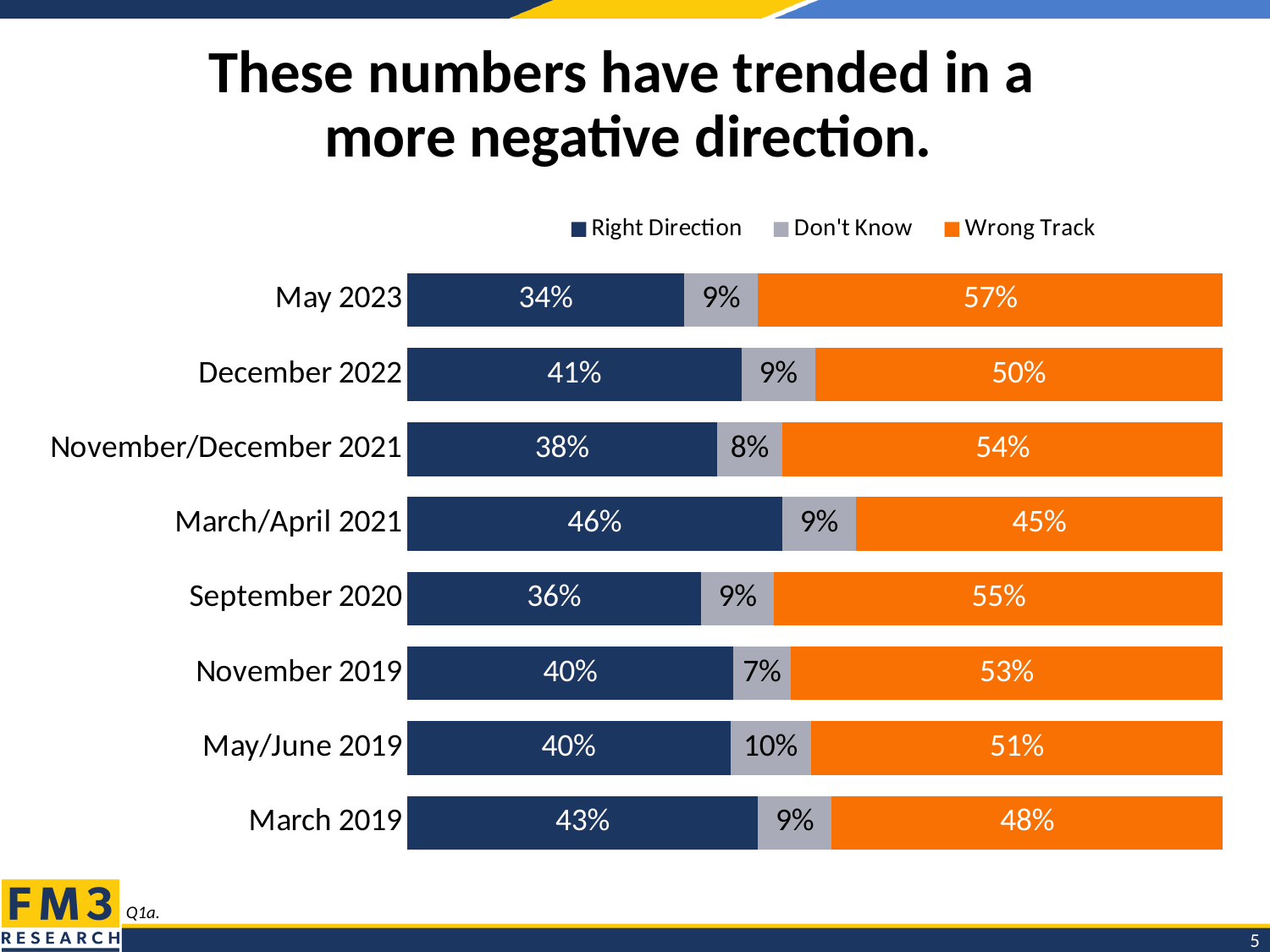
What is the difference between the "Wrong Track" and "Right Direction" percentages in May 2023? 23 percentage points Which colour represents "Wrong Track" in the chart? Orange How many survey periods are shown in the chart? 8 What percentage said "Wrong Track" in March/April 2021? 45% What is the "Don't Know" value for May/June 2019? 10% How many series does the legend list? 3 Which is larger in December 2022: "Right Direction" or "Wrong Track"? Wrong Track What is the total of the three segments for the November 2019 bar? 100% Which survey period has the highest "Wrong Track" percentage? May 2023 What kind of chart is shown on the slide? Stacked bar chart Which survey period has the lowest "Right Direction" percentage? May 2023 What percentage said "Right Direction" in May 2023? 34%